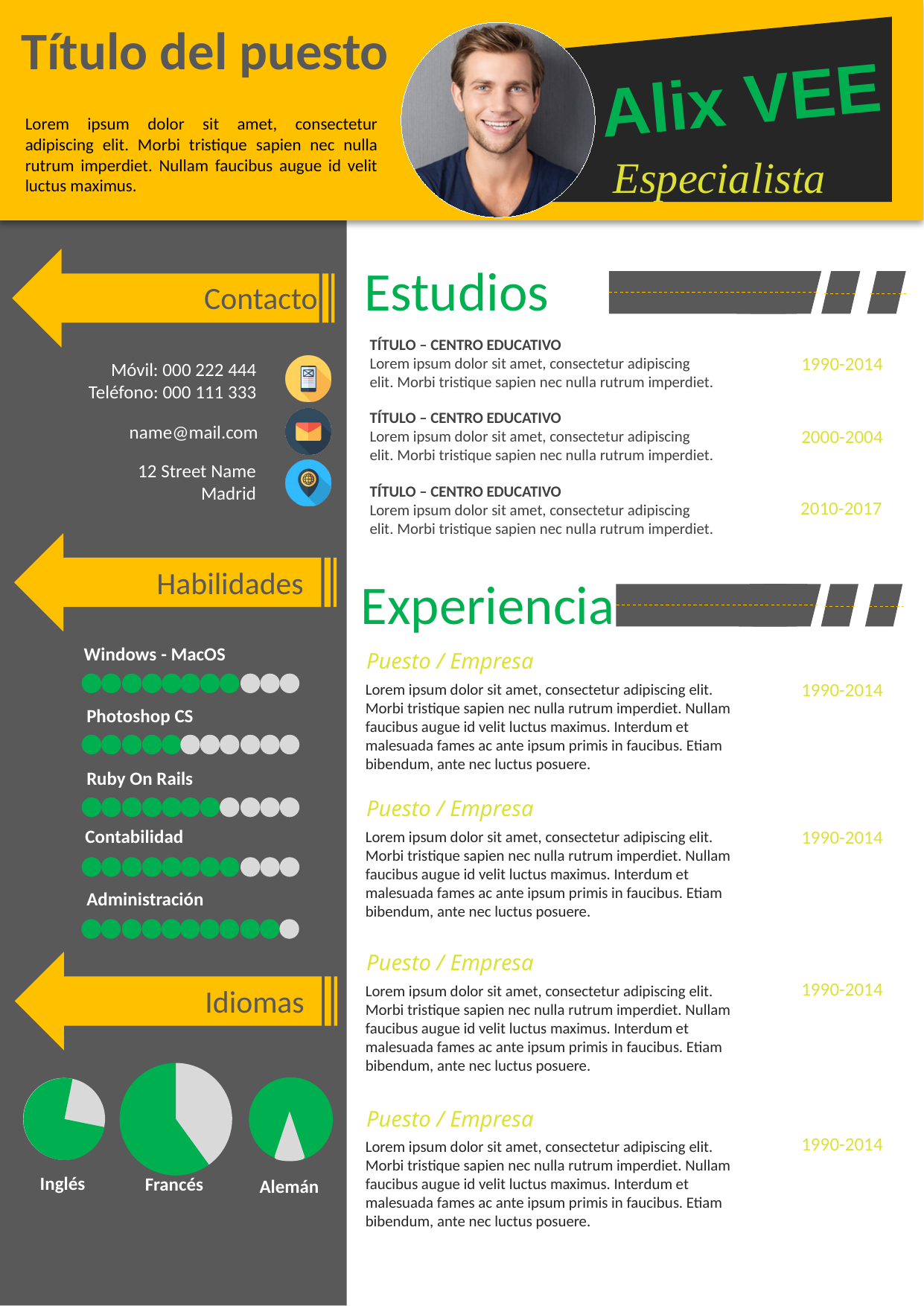
In the Habilidades section, how many dots are filled green for Administración? 11 How many pie charts are shown in the Idiomas section? 3 In the Idiomas pie charts, which has a larger grey share, Francés or Alemán? Francés What kind of charts are used in the Idiomas section? Pie charts In the Habilidades section, which skill has the fewest green dots? Photoshop CS Which language pie chart in the Idiomas section has the largest green share? Alemán What two colours are used in the Idiomas pie charts? Green and grey Which language pie chart in the Idiomas section has the smallest green share? Francés In the Habilidades section, how many skills are rated with dots? 5 In the Idiomas pie charts, which has a larger green share, Inglés or Francés? Inglés In the Habilidades section, how many dots are filled green for Photoshop CS? 6 What are the labels of the three pie charts in the Idiomas section, from left to right? Inglés, Francés, Alemán